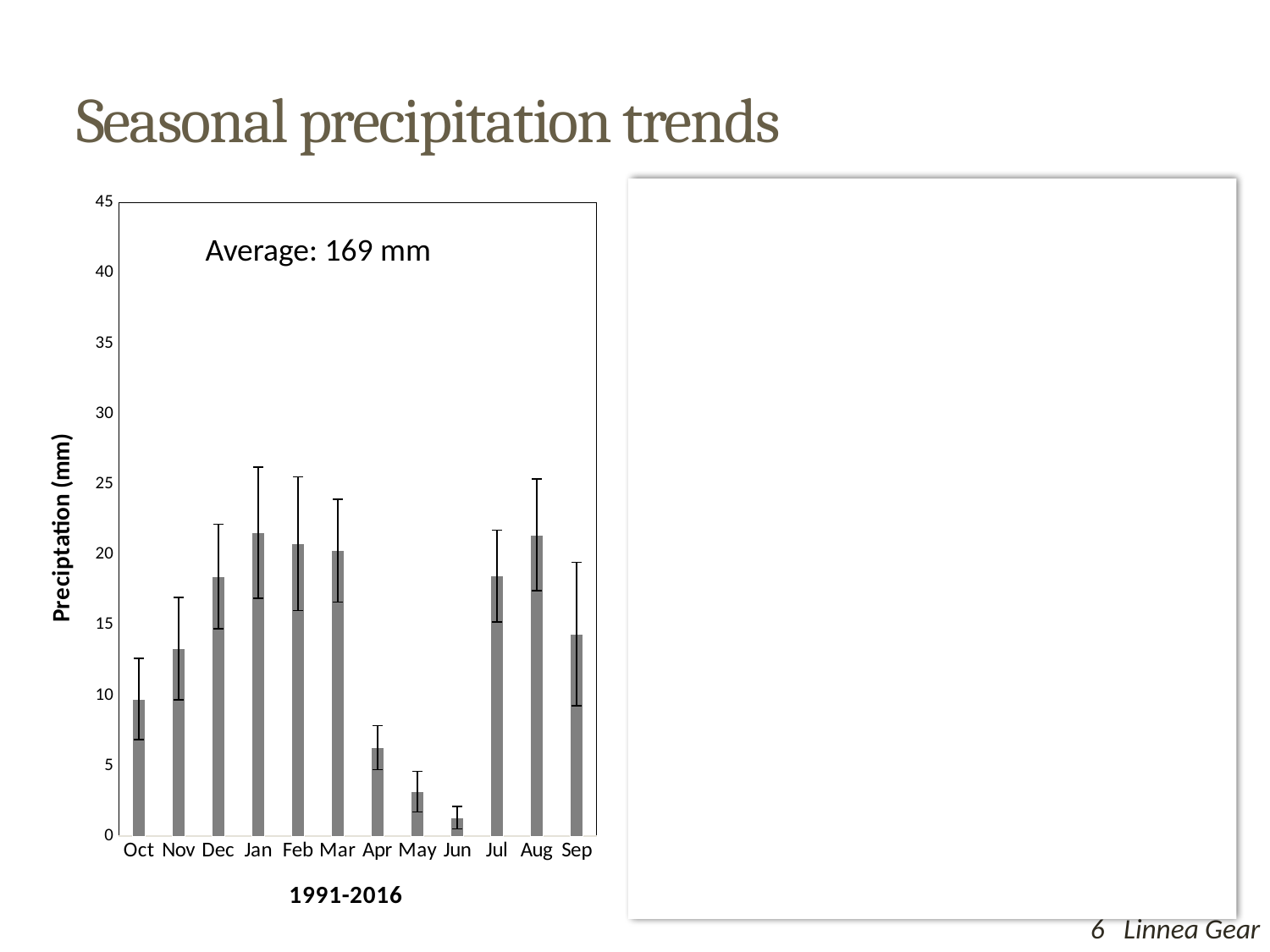
How many months are plotted on the x axis of the chart? 12 Do the precipitation values rise or fall from Jan to Jun along the x axis? fall What is the x-axis title of the chart? 1991-2016 What kind of chart is shown on the slide? bar chart Is the precipitation value for Jan greater or less than 20? greater Which has the higher precipitation, Dec or Apr? Dec What average value is printed inside the chart area? Average: 169 mm Which month has the lowest precipitation in the chart? Jun Is the precipitation value for Jul greater or less than 15? greater Is the precipitation value for May greater or less than 5? less